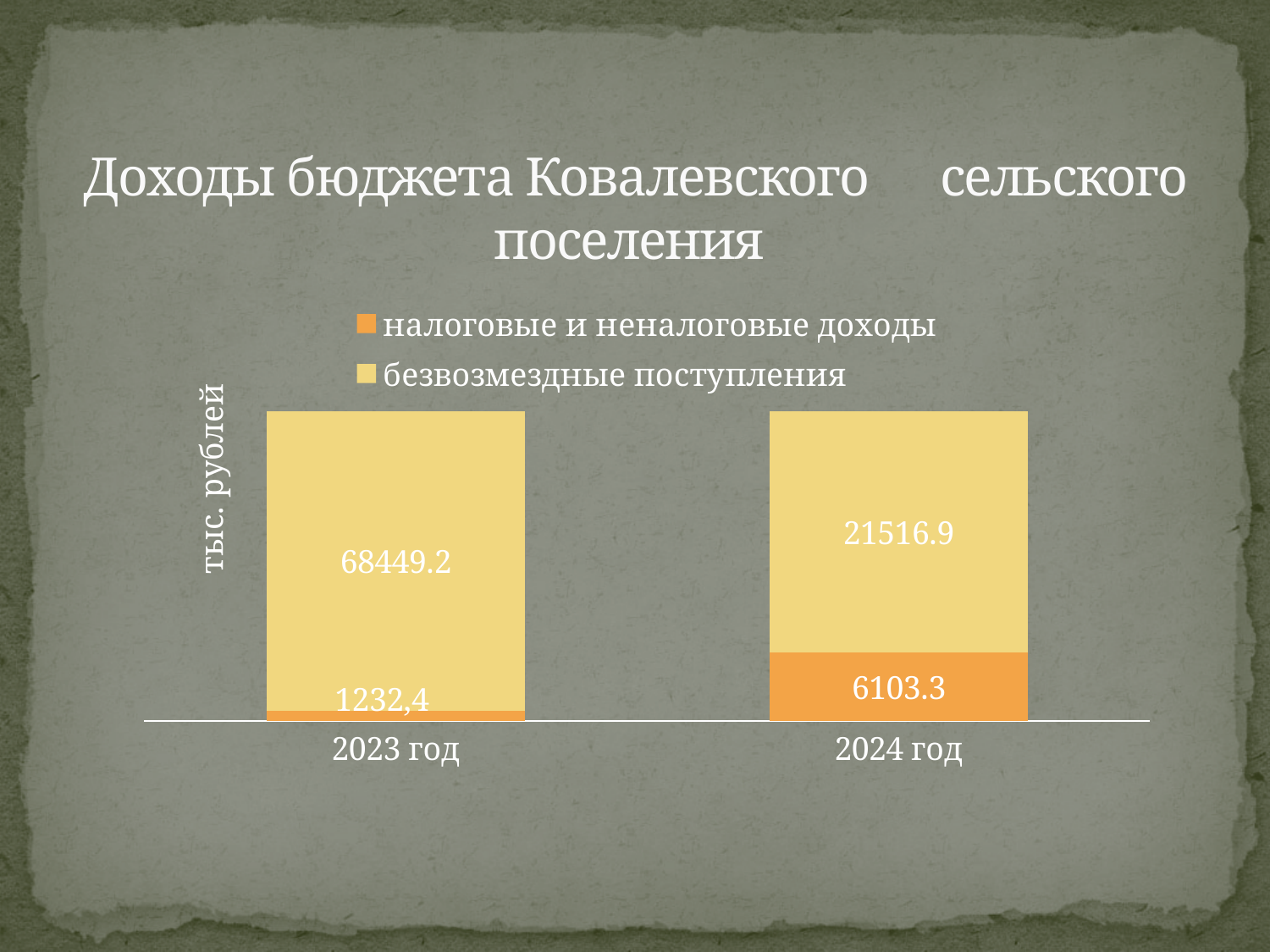
What is the value of налоговые и неналоговые доходы for 2024 год? 6103.3 What is the value of безвозмездные поступления for 2024 год? 21516.9 How many categories (years) are shown on the x axis? 2 Which year has the higher value for безвозмездные поступления? 2023 год What is the value of безвозмездные поступления for 2023 год? 68449.2 What is the value of налоговые и неналоговые доходы for 2023 год? 1232,4 What kind of chart is shown on the slide? Stacked bar chart What is the difference between безвозмездные поступления in 2023 год and 2024 год? 46932.3 Is the value of налоговые и неналоговые доходы larger in 2023 год or 2024 год? 2024 год Which year has the lower value for налоговые и неналоговые доходы? 2023 год How many series does the legend list? 2 What is the total of the stacked bar for 2024 год? 27620.2